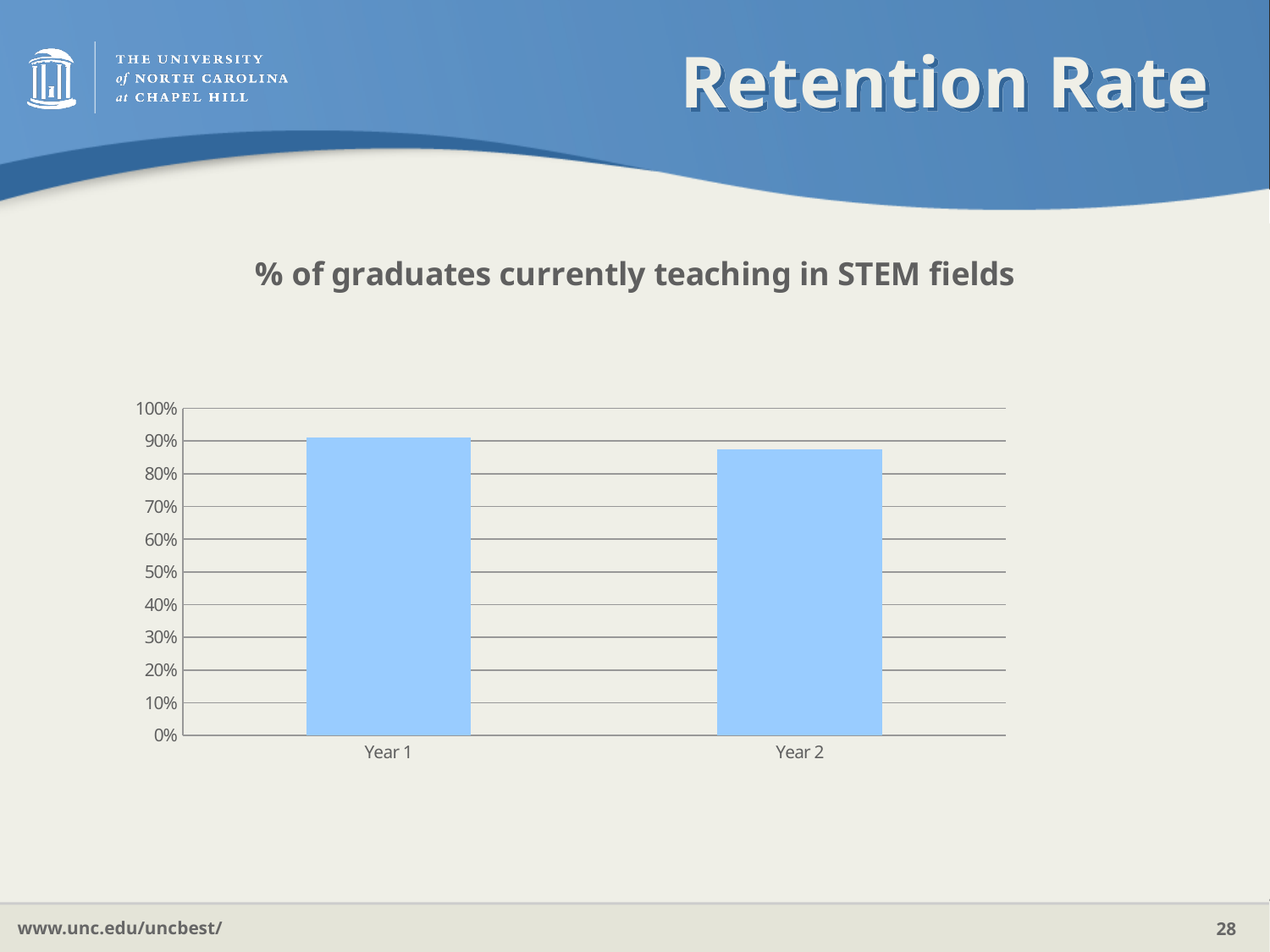
Is the value for Year 2 greater or less than 90%? less Which year has the lowest percentage of graduates currently teaching in STEM fields? Year 2 Is the value for Year 2 greater or less than 80%? greater Which year has the highest percentage of graduates currently teaching in STEM fields? Year 1 Is the value for Year 1 greater or less than 50%? greater What is the title of the chart? % of graduates currently teaching in STEM fields What kind of chart is shown on the slide? bar chart Which is larger, the value for Year 1 or the value for Year 2? Year 1 What is the highest value shown on the vertical axis? 100% How many categories are plotted on the x axis? 2 Do the values rise or fall from Year 1 to Year 2? fall